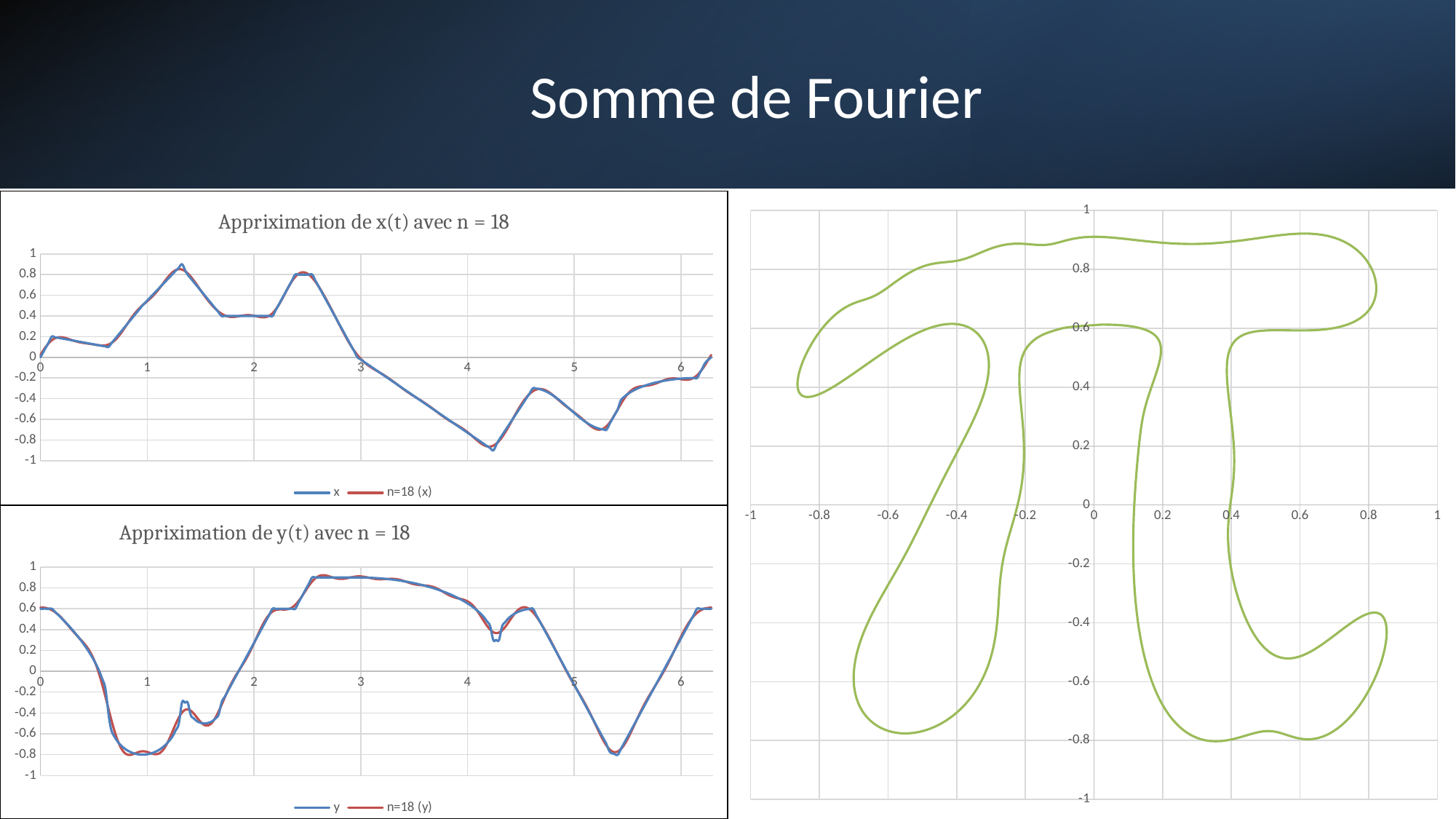
What is the title of the top-left chart? Appriximation de x(t) avec n = 18 In the chart titled 'Appriximation de x(t) avec n = 18', which is larger: the value of x at t = 1 or at t = 4? t = 1 What symbol does the curve in the chart on the right of the slide trace out? π (pi) In the chart titled 'Appriximation de y(t) avec n = 18', how many series does the legend list? 2 What kind of chart is the one titled 'Appriximation de y(t) avec n = 18'? Line chart In the chart titled 'Appriximation de y(t) avec n = 18', does the value of y rise or fall between t = 0 and t = 1? fall In the chart titled 'Appriximation de y(t) avec n = 18', is the value of y at t = 3 greater or less than 0.6? greater In the chart titled 'Appriximation de x(t) avec n = 18', is the value of x at t = 4 greater or less than -0.4? less In the chart titled 'Appriximation de y(t) avec n = 18', is the value of y at t = 1 greater or less than -0.4? less In the chart titled 'Appriximation de x(t) avec n = 18', does the value of x rise or fall between t = 3 and t = 4? fall In the chart titled 'Appriximation de x(t) avec n = 18', how many series does the legend list? 2